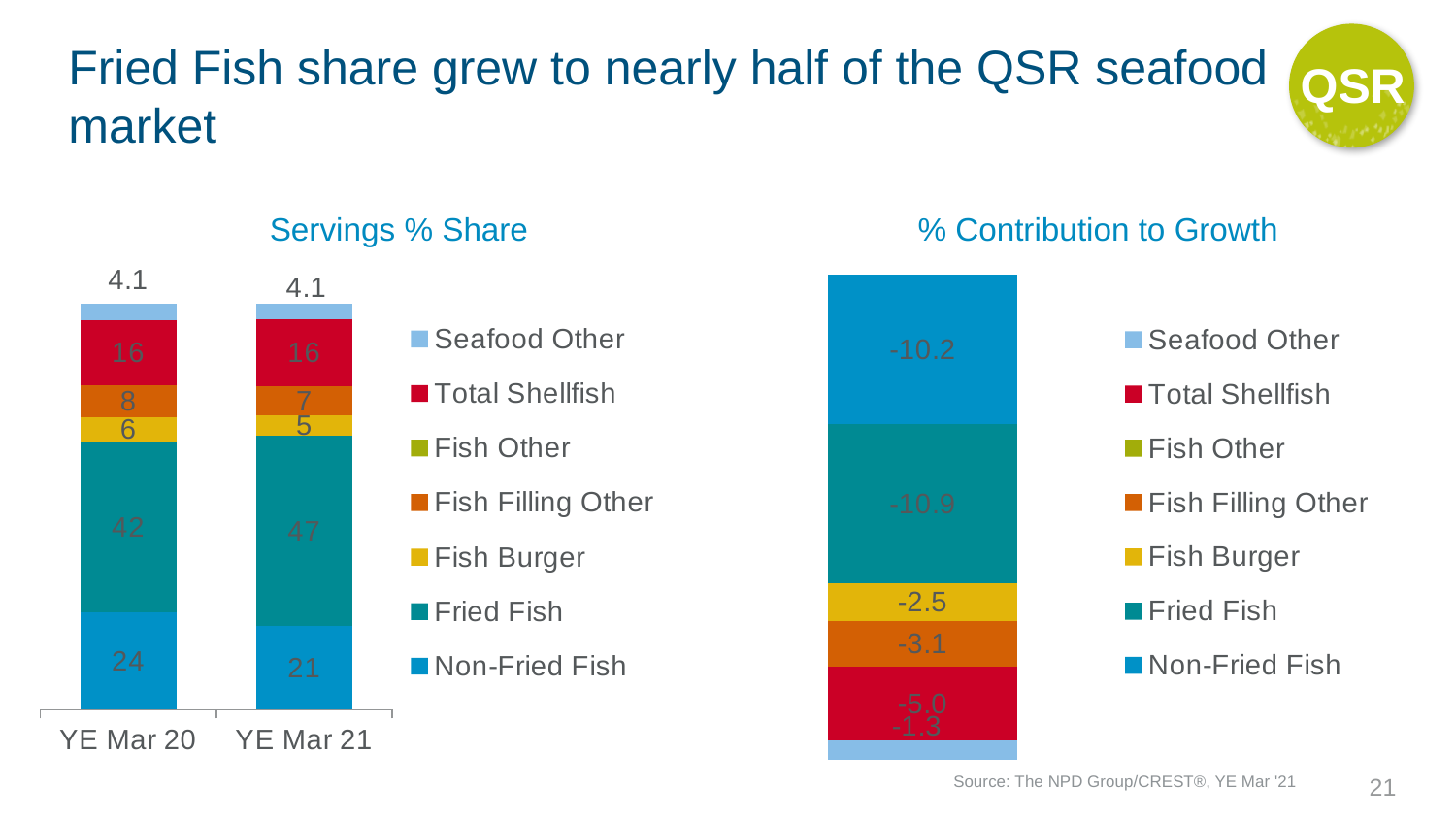
In the % Contribution to Growth chart, what is the value for Non-Fried Fish? -10.2 What kind of chart is the Servings % Share chart? stacked bar chart In the Servings % Share chart, what is the value for Fish Filling Other in YE Mar 20? 8 How many series does the legend of the Servings % Share chart list? 7 In the Servings % Share chart, does the Fried Fish value rise or fall from YE Mar 20 to YE Mar 21? rise How many categories are shown on the x axis of the Servings % Share chart? 2 In the Servings % Share chart, what is the value for Fried Fish in YE Mar 21? 47 In the Servings % Share chart, which year has the larger Non-Fried Fish value, YE Mar 20 or YE Mar 21? YE Mar 20 In the % Contribution to Growth chart, what is the value for Fried Fish? -10.9 In the Servings % Share chart, by how much did the Fried Fish value change from YE Mar 20 to YE Mar 21? 5 In the Servings % Share chart, what is the value for Non-Fried Fish in YE Mar 20? 24 In the % Contribution to Growth chart, what is the value for Fish Burger? -2.5